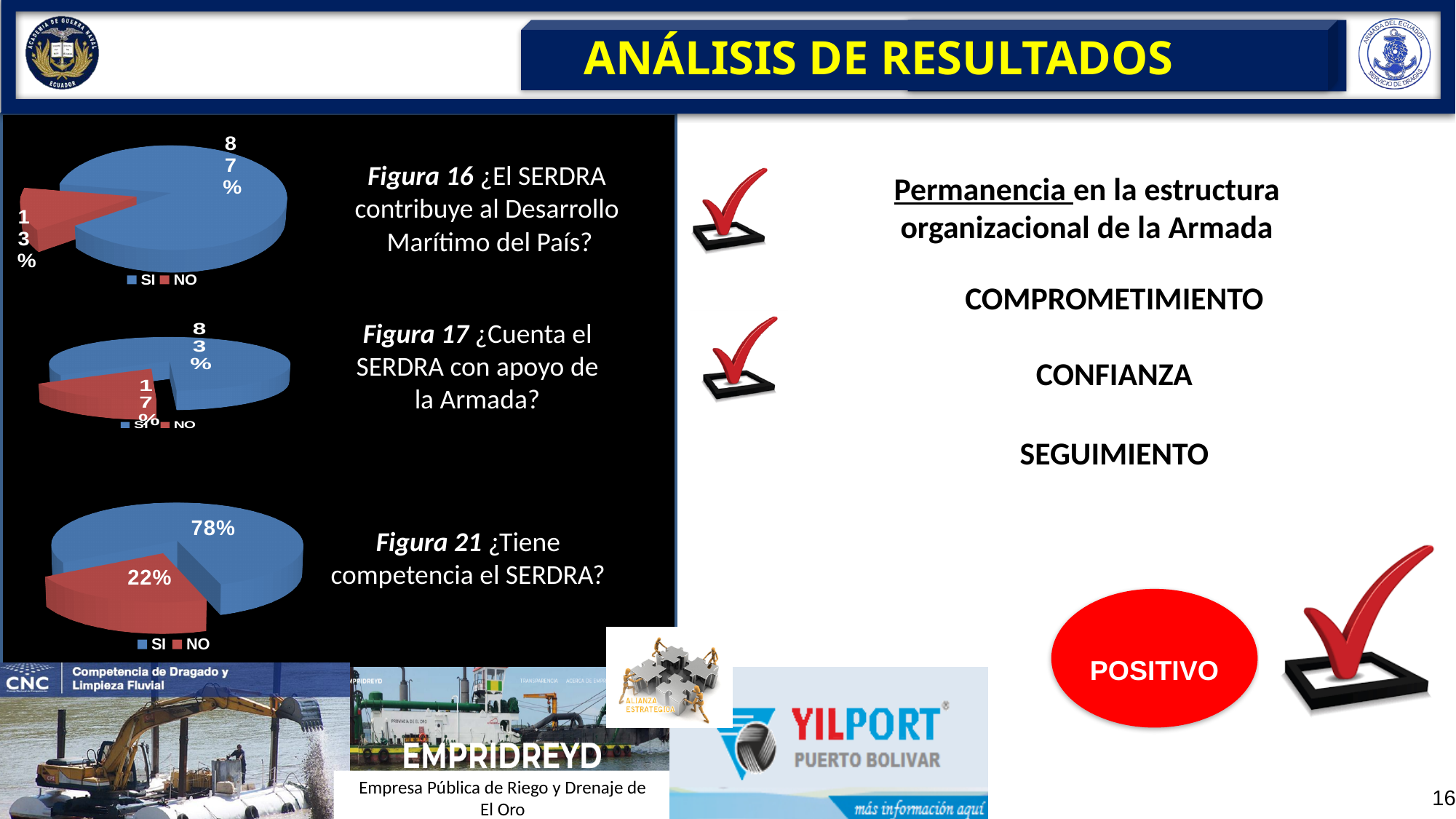
In the Figura 17 pie chart (¿Cuenta el SERDRA con apoyo de la Armada?), what percentage answered SI? 83% In the Figura 16 pie chart (¿El SERDRA contribuye al Desarrollo Marítimo del País?), what percentage answered SI? 87% How many entries does the legend of the Figura 16 chart list? 2 In the Figura 21 pie chart, what percentage answered NO? 22% In the Figura 21 pie chart (¿Tiene competencia el SERDRA?), what percentage answered SI? 78% In the Figura 16 pie chart, what is the difference between the SI and NO percentages? 74% What type of chart is used for Figura 21? Pie chart In the Figura 17 pie chart, what percentage answered NO? 17% In the Figura 21 pie chart, which response has the larger share, SI or NO? SI In the Figura 17 pie chart, what is the difference between the SI and NO percentages? 66% In the Figura 16 pie chart, what percentage answered NO? 13% In the Figura 17 pie chart, which colour represents the NO response? Red